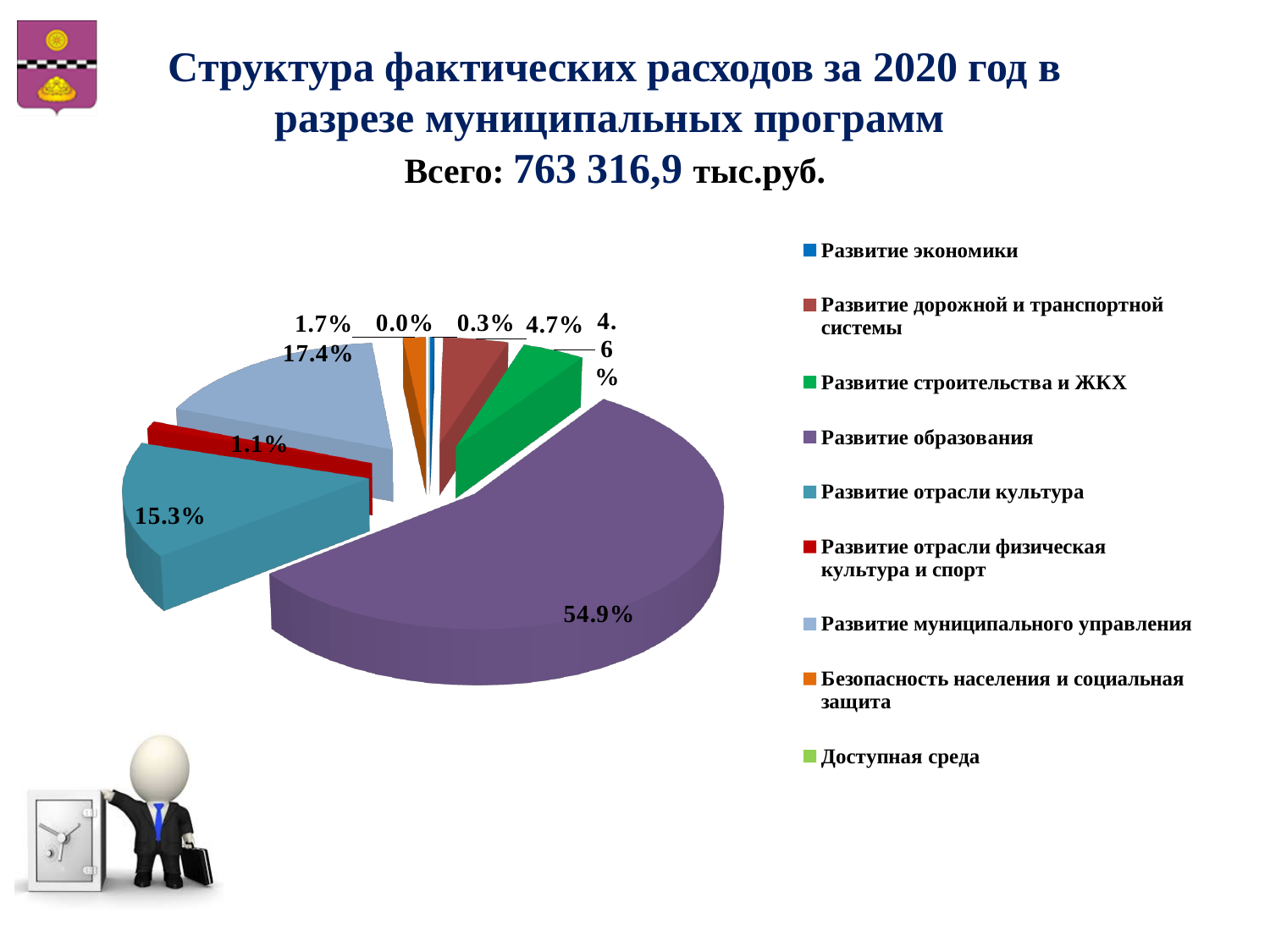
What share of expenditures does «Развитие муниципального управления» account for? 17.4% What total amount of actual expenditures for 2020 is stated on the slide? 763 316,9 тыс.руб. Which has a larger share: «Развитие муниципального управления» or «Развитие отрасли культура»? Развитие муниципального управления What share of expenditures does «Развитие отрасли культура» account for? 15.3% What share of expenditures does «Развитие образования» account for? 54.9% What share of expenditures does «Развитие отрасли физическая культура и спорт» account for? 1.1% Which municipal program has the largest share of expenditures? Развитие образования What share of expenditures does «Безопасность населения и социальная защита» account for? 1.7% What type of chart is shown on the slide? pie chart How many municipal programs are listed in the legend? 9 By how many percentage points does the share of «Развитие образования» exceed that of «Развитие отрасли культура»? 39.6 percentage points Which municipal program has the smallest share of expenditures? Доступная среда